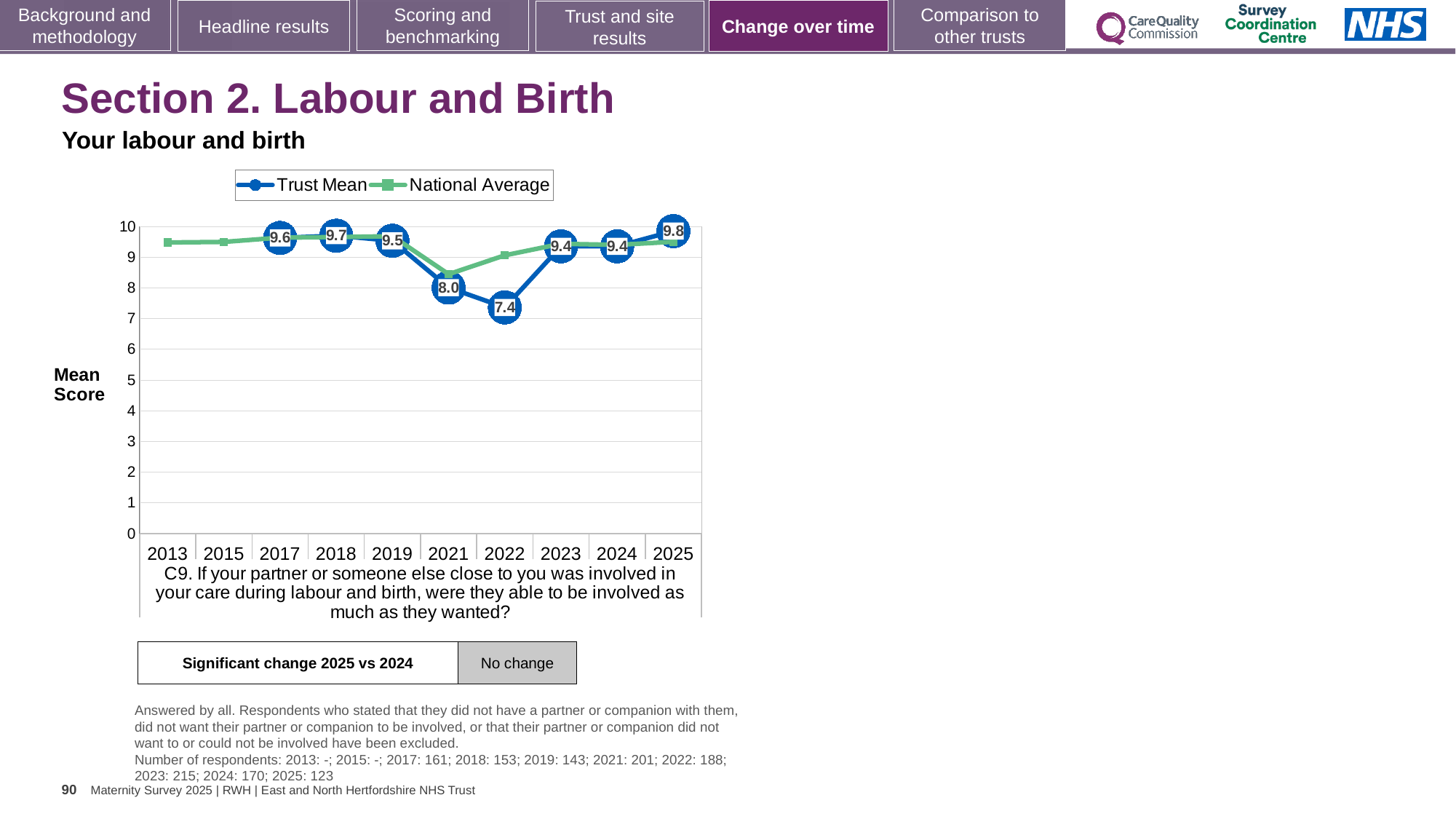
In which year is the Trust Mean highest? 2025 What is the Trust Mean value for 2021? 8.0 Which is larger, the Trust Mean in 2018 or in 2019? 2018 What kind of chart is shown? line chart How many years are shown on the x axis? 10 What is the Trust Mean value for 2022? 7.4 What is the difference between the Trust Mean in 2025 and in 2024? 0.4 How many series does the legend list? 2 What is the Trust Mean value for 2025? 9.8 Does the Trust Mean rise or fall from 2019 to 2022? fall In which year is the Trust Mean lowest? 2022 Is the National Average value for 2021 greater or less than 9? less